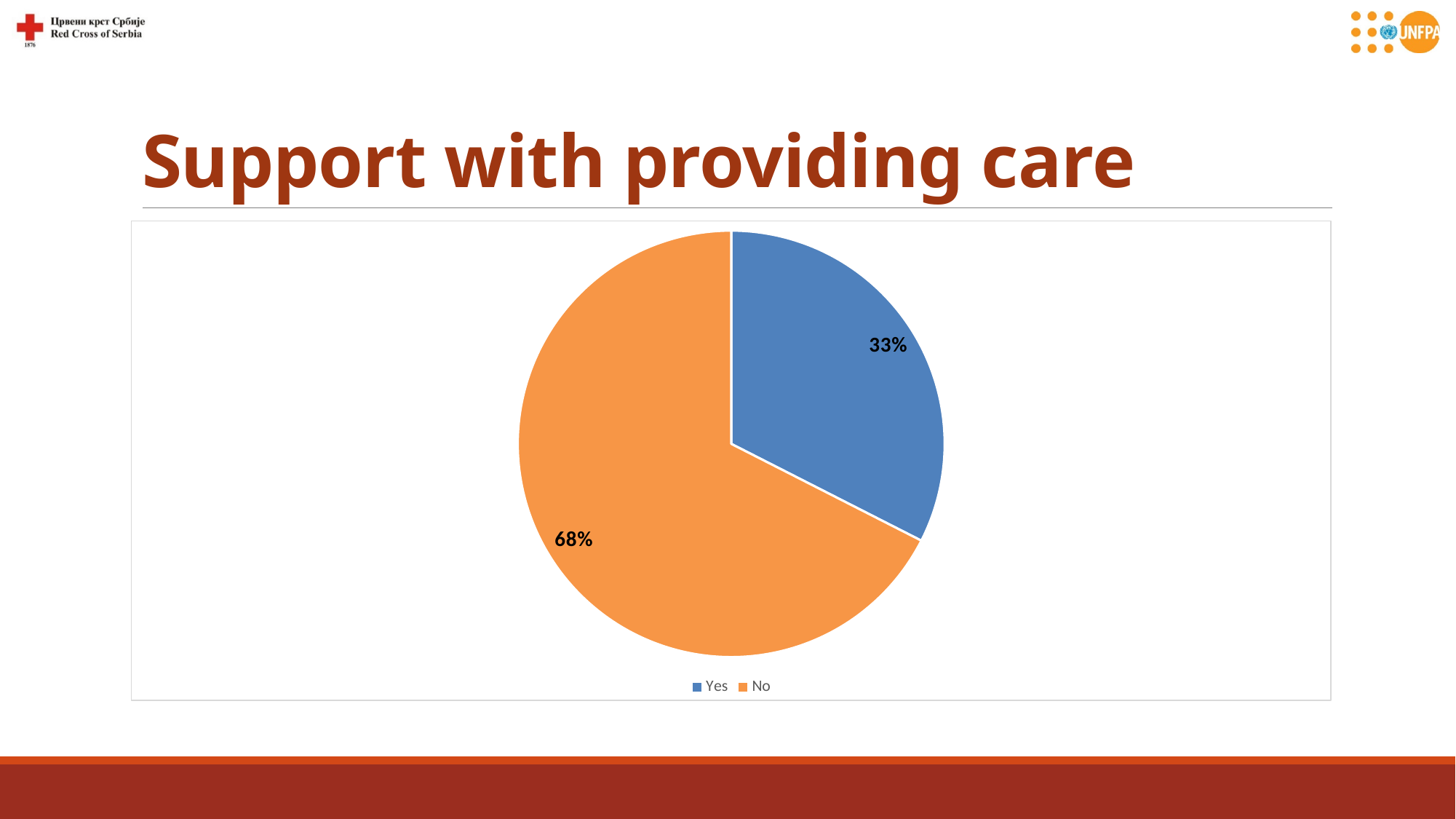
How many slices does the pie chart have? 2 What is the title of the slide containing the pie chart? Support with providing care What colour is the "No" slice of the pie chart? orange What kind of chart is shown on the slide? pie chart Which is larger, the "Yes" slice or the "No" slice? No What percentage of the pie is labelled "Yes"? 33% What is the difference in percentage points between the "No" slice and the "Yes" slice? 35 Which slice of the pie is the smallest? Yes How many entries does the legend list? 2 Which slice of the pie is the largest? No What percentage of the pie is labelled "No"? 68%